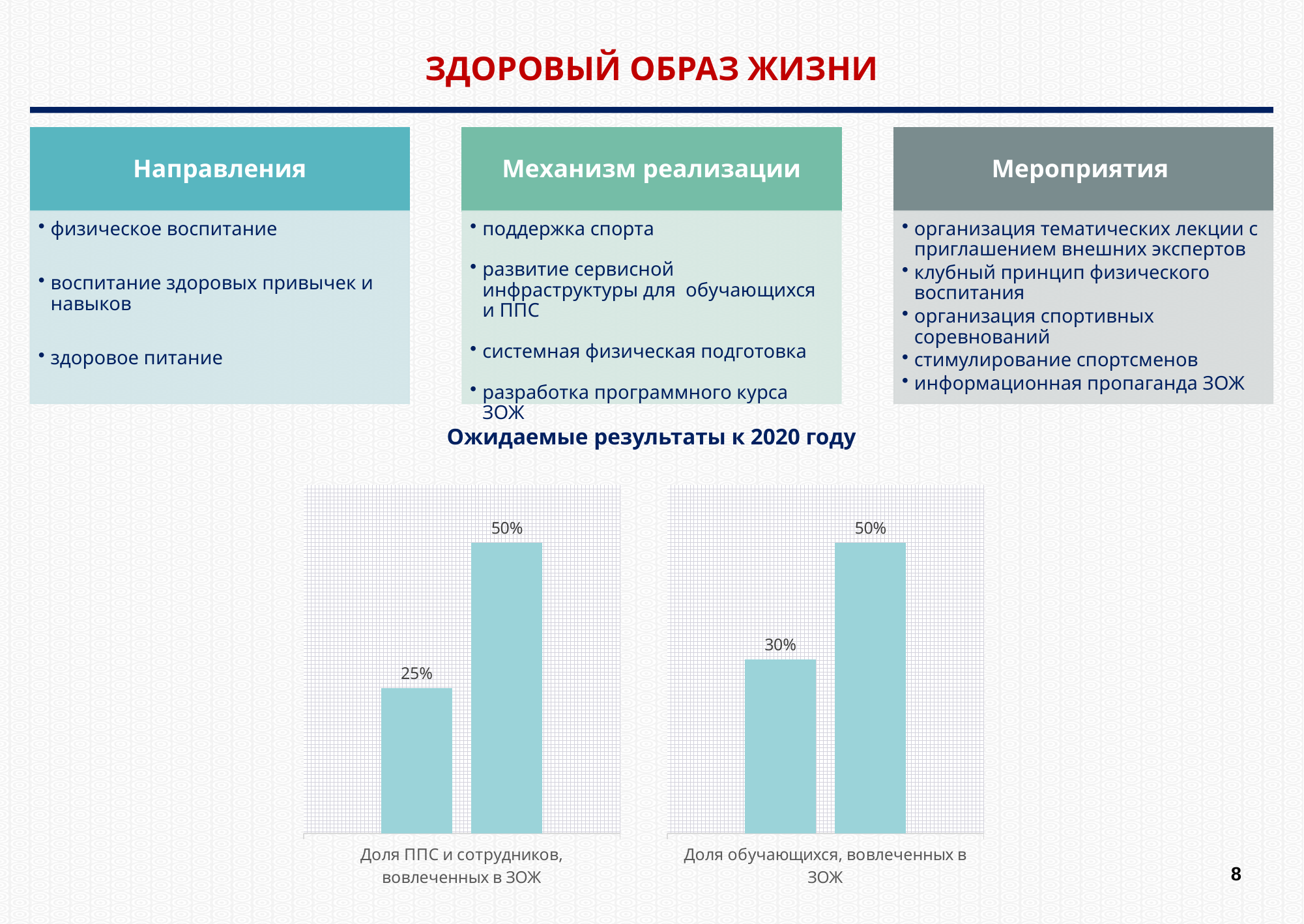
How many charts are shown on the slide under the heading 'Ожидаемые результаты к 2020 году'? 2 What type of chart is the left chart, 'Доля ППС и сотрудников, вовлеченных в ЗОЖ'? bar chart In the right chart, 'Доля обучающихся, вовлеченных в ЗОЖ', what is the difference between the two bars? 20% In the right chart, 'Доля обучающихся, вовлеченных в ЗОЖ', what is the value of the right (second) bar? 50% In the left chart, 'Доля ППС и сотрудников, вовлеченных в ЗОЖ', what is the value of the left (first) bar? 25% In the left chart, 'Доля ППС и сотрудников, вовлеченных в ЗОЖ', what is the difference between the two bars? 25% How many bars does the right chart, 'Доля обучающихся, вовлеченных в ЗОЖ', contain? 2 Which is larger: the first bar of the left chart (Доля ППС и сотрудников) or the first bar of the right chart (Доля обучающихся)? the first bar of the right chart (Доля обучающихся) In the right chart, 'Доля обучающихся, вовлеченных в ЗОЖ', what is the value of the left (first) bar? 30% In the left chart, 'Доля ППС и сотрудников, вовлеченных в ЗОЖ', which bar is taller, the left one or the right one? the right one In the right chart, 'Доля обучающихся, вовлеченных в ЗОЖ', do the values rise or fall from left to right? rise In the left chart, 'Доля ППС и сотрудников, вовлеченных в ЗОЖ', what is the value of the right (second) bar? 50%